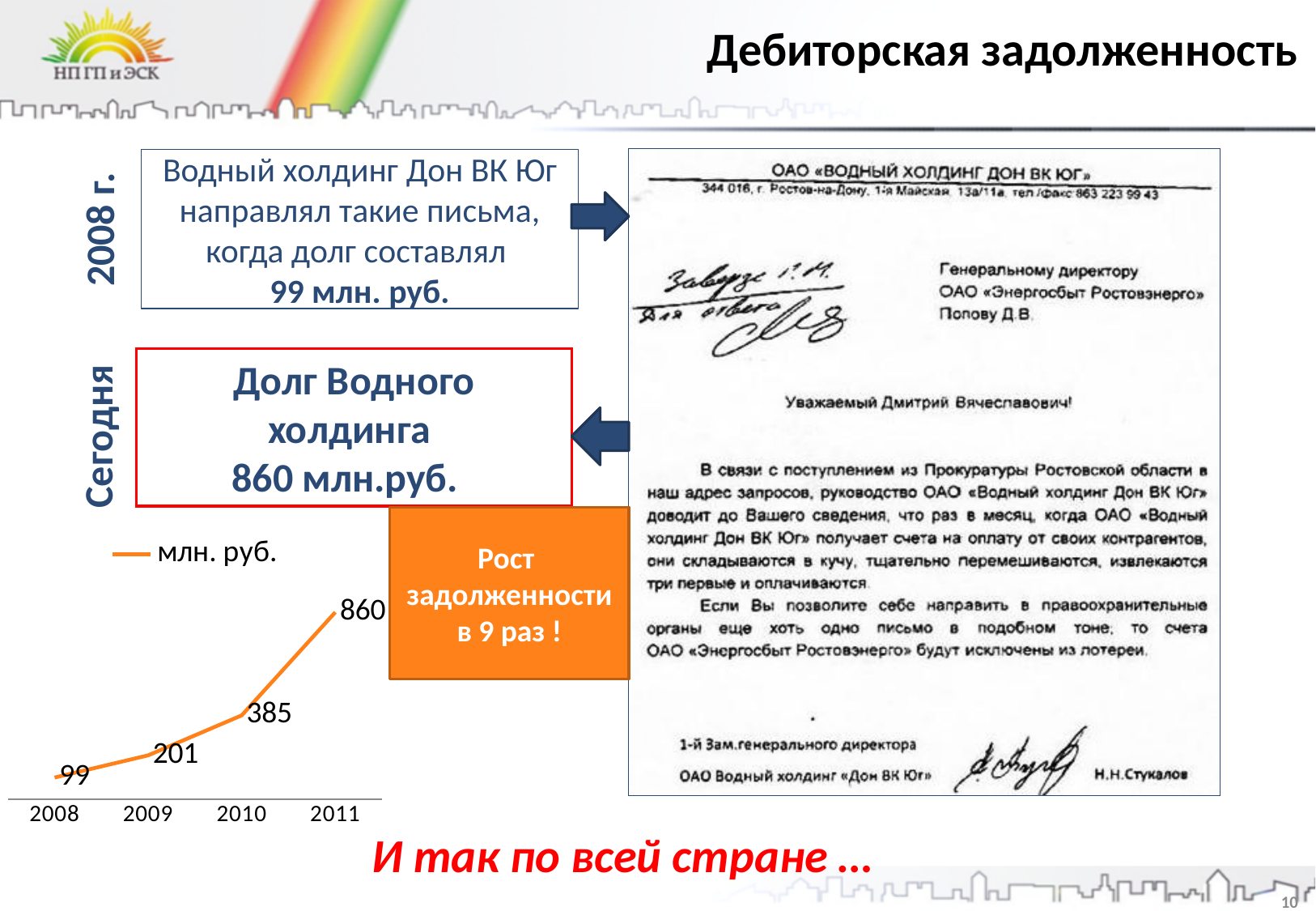
What is the value for 2010 on the chart? 385 What is the difference between the values for 2011 and 2008? 761 How many years are plotted on the chart? 4 What is the value for 2009 on the chart? 201 Which is larger, the value for 2010 or the value for 2009? 2010 What type of chart is shown on the slide? line chart Do the values rise or fall from 2008 to 2011? rise Which year has the lowest value on the chart? 2008 What is the value for 2008 on the chart? 99 What is the value for 2011 on the chart? 860 Which year has the highest value on the chart? 2011 How many series does the chart legend list? 1